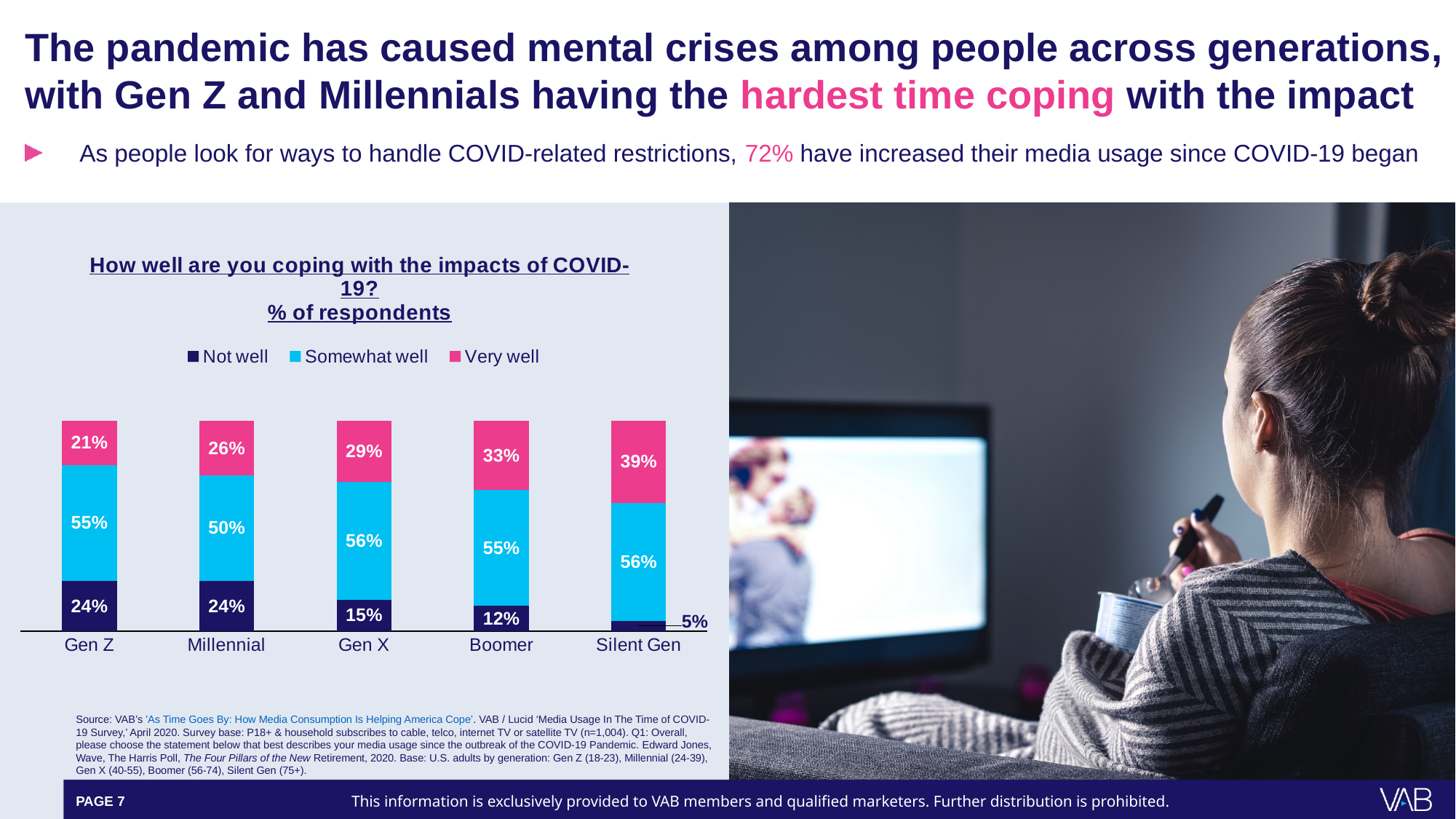
How many generations are shown on the x axis of the chart? 5 What percentage of Silent Gen respondents said they are coping 'Very well'? 39% Which generation has the lowest 'Not well' percentage? Silent Gen How many series does the chart legend list? 3 Which generation has the highest 'Very well' percentage? Silent Gen What colour represents the 'Somewhat well' series in the chart? Light blue What percentage of Gen Z respondents said they are coping 'Not well'? 24% What kind of chart is shown on the slide? Stacked bar chart What is the difference between the 'Very well' percentages for Silent Gen and Gen Z? 18% Which is larger: the 'Not well' percentage for Gen X or for Boomer? Gen X Does the 'Very well' percentage rise or fall moving from Gen Z to Silent Gen? Rise What percentage of Boomer respondents said they are coping 'Somewhat well'? 55%